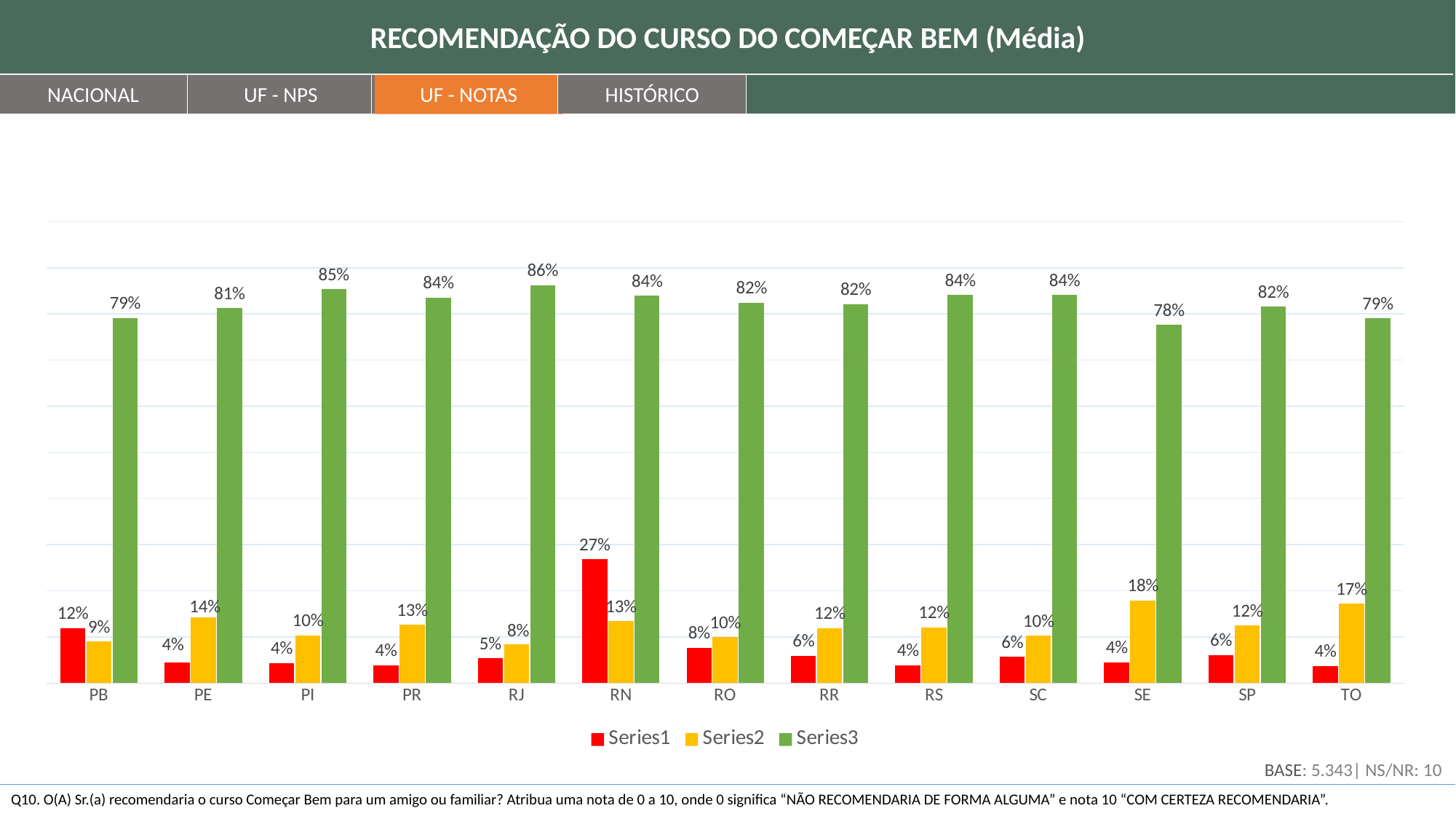
What colour are the Series3 bars? Green Which category has the highest Series1 value? RN How many categories are shown on the x axis? 13 Which category has the highest Series3 value? RJ How many series does the legend list? 3 What kind of chart is shown on the slide? Bar chart What is the Series1 value for RN? 27% What is the Series3 value for RJ? 86% Which is larger, the Series2 value for TO or the Series2 value for PB? TO What is the Series2 value for SE? 18% What is the difference between the Series3 values for RJ and SE? 8% Which category has the lowest Series3 value? SE